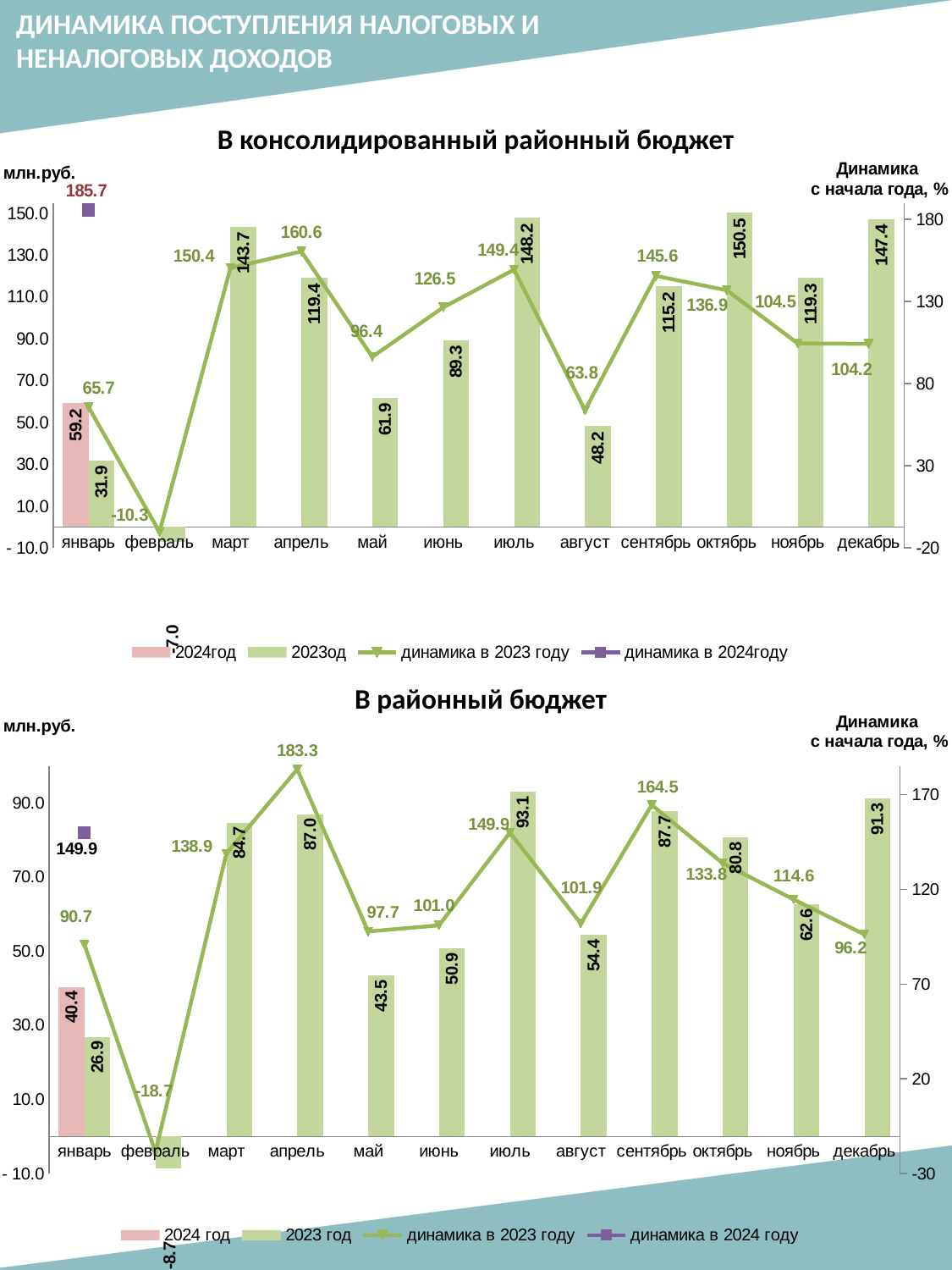
In the chart 'В районный бюджет', which month has the highest 2023 год bar? июль In the chart 'В районный бюджет', what is the value of 'динамика в 2023 году' for апрель? 183.3 In the chart 'В консолидированный районный бюджет', what is the value of the 2023 год bar for октябрь? 150.5 In the chart 'В консолидированный районный бюджет', what is the value of the 2024год bar for январь? 59.2 In the chart 'В районный бюджет', what is the value of the 2023 год bar for февраль? -8.7 How many series does the legend of the chart 'В районный бюджет' list? 4 In the chart 'В консолидированный районный бюджет', what is the difference between the 2024год and 2023од bars for январь? 27.3 How many months are shown on the x axis of the chart 'В консолидированный районный бюджет'? 12 In the chart 'В консолидированный районный бюджет', which month has the lowest value of 'динамика в 2023 году'? февраль In the chart 'В консолидированный районный бюджет', what is the value of 'динамика в 2024году' for январь? 185.7 In the chart 'В районный бюджет', which is larger: the 2023 год bar for сентябрь or for декабрь? декабрь In the chart 'В консолидированный районный бюджет', which month has the highest 2023 год bar? октябрь